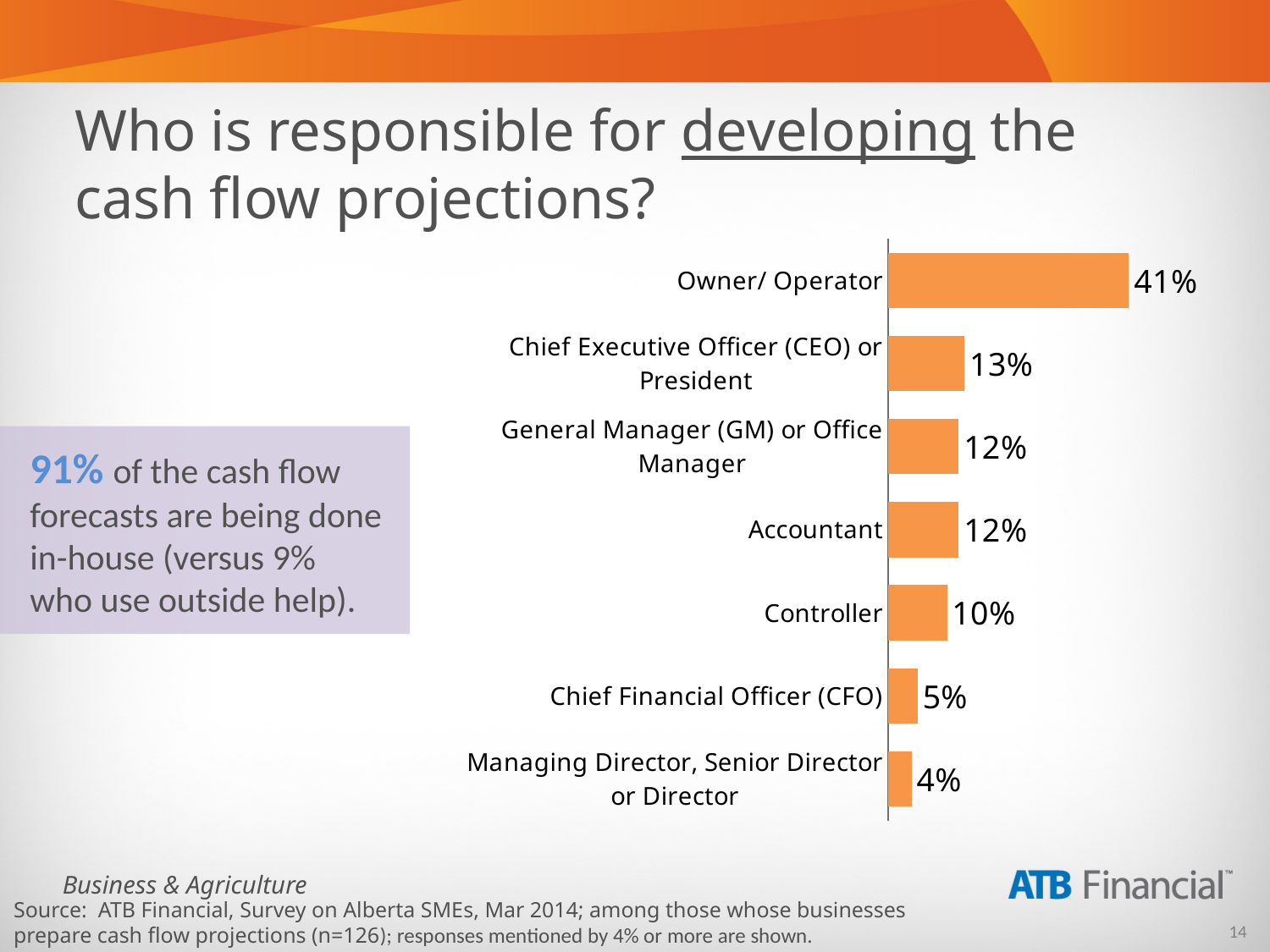
Which is larger, the value for Controller or the value for Accountant? Accountant What colour are the bars in the chart? Orange What kind of chart is shown on the slide? Bar chart What is the difference between the values for Controller and Chief Financial Officer (CFO)? 5% What percentage is shown for Chief Executive Officer (CEO) or President? 13% Which category has the lowest value? Managing Director, Senior Director or Director Which category has the highest value? Owner/ Operator What percentage is shown for Controller? 10% What percentage is shown for Owner/ Operator? 41% What is the difference between the values for Owner/ Operator and Chief Executive Officer (CEO) or President? 28% How many categories are shown in the chart? 7 What percentage is shown for Chief Financial Officer (CFO)? 5%